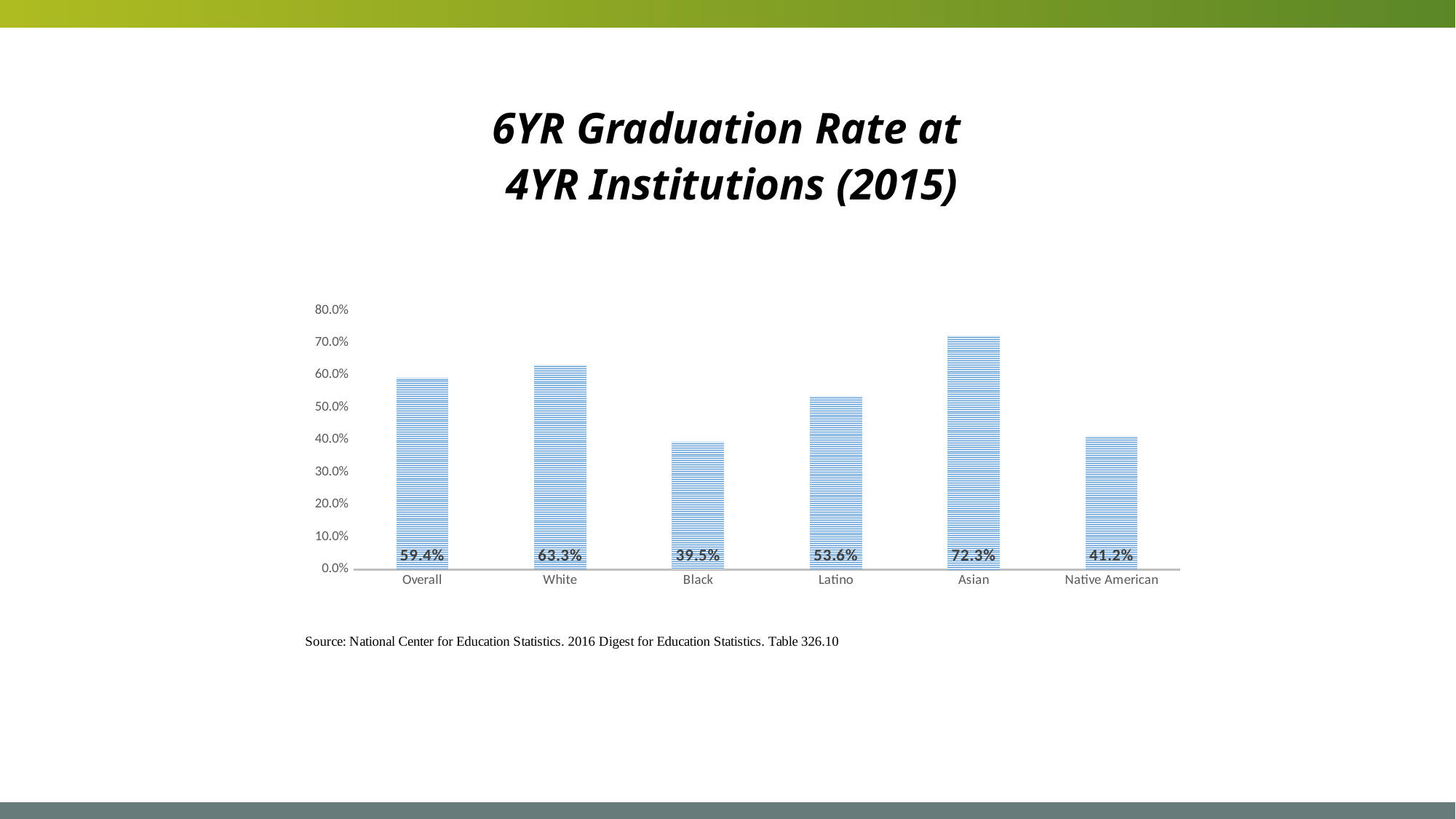
Is the value for White greater or less than 60.0%? greater Which is larger, the graduation rate for Latino students or for Native American students? Latino What is the 6-year graduation rate for Asian students? 72.3% What is the Overall 6-year graduation rate shown? 59.4% How many categories are shown on the x axis? 6 Which category has the highest 6-year graduation rate? Asian What is the 6-year graduation rate for Black students? 39.5% What is the 6-year graduation rate for Native American students? 41.2% What kind of chart is shown on the slide? Bar chart What is the difference between the White and Black graduation rates? 23.8% Which category has the lowest 6-year graduation rate? Black What is the difference between the Asian and Overall graduation rates? 12.9%